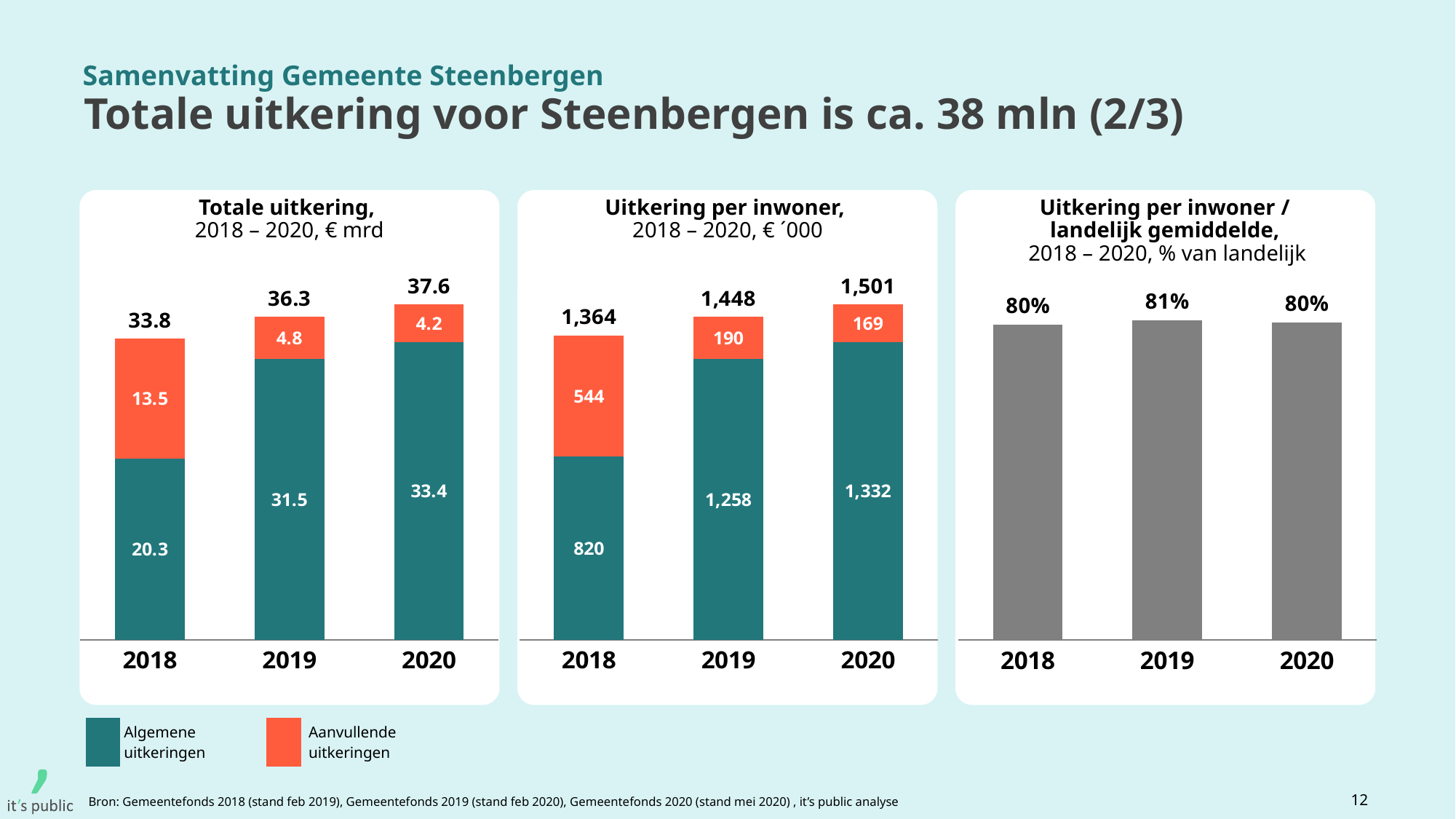
In the 'Totale uitkering' chart, what is the difference between Aanvullende uitkeringen in 2018 and 2019? 8.7 In the 'Uitkering per inwoner' chart, is Algemene uitkeringen larger in 2019 or 2020? 2020 In the 'Totale uitkering' chart, what is the value of Algemene uitkeringen for 2018? 20.3 In the 'Uitkering per inwoner' chart, what is the value of Aanvullende uitkeringen for 2019? 190 In the 'Uitkering per inwoner' chart, which year has the highest total? 2020 How many series does the legend at the bottom of the slide list? 2 In the 'Uitkering per inwoner' chart, what is the total for 2018? 1,364 In the 'Totale uitkering' chart, which year has the lowest total? 2018 What kind of chart is the 'Totale uitkering' chart? Stacked bar chart In the 'Totale uitkering' chart, what is the total of the stacked bar for 2020? 37.6 How many years are shown on the x axis of the 'Uitkering per inwoner / landelijk gemiddelde' chart? 3 In the 'Uitkering per inwoner / landelijk gemiddelde' chart, what is the value for 2019? 81%